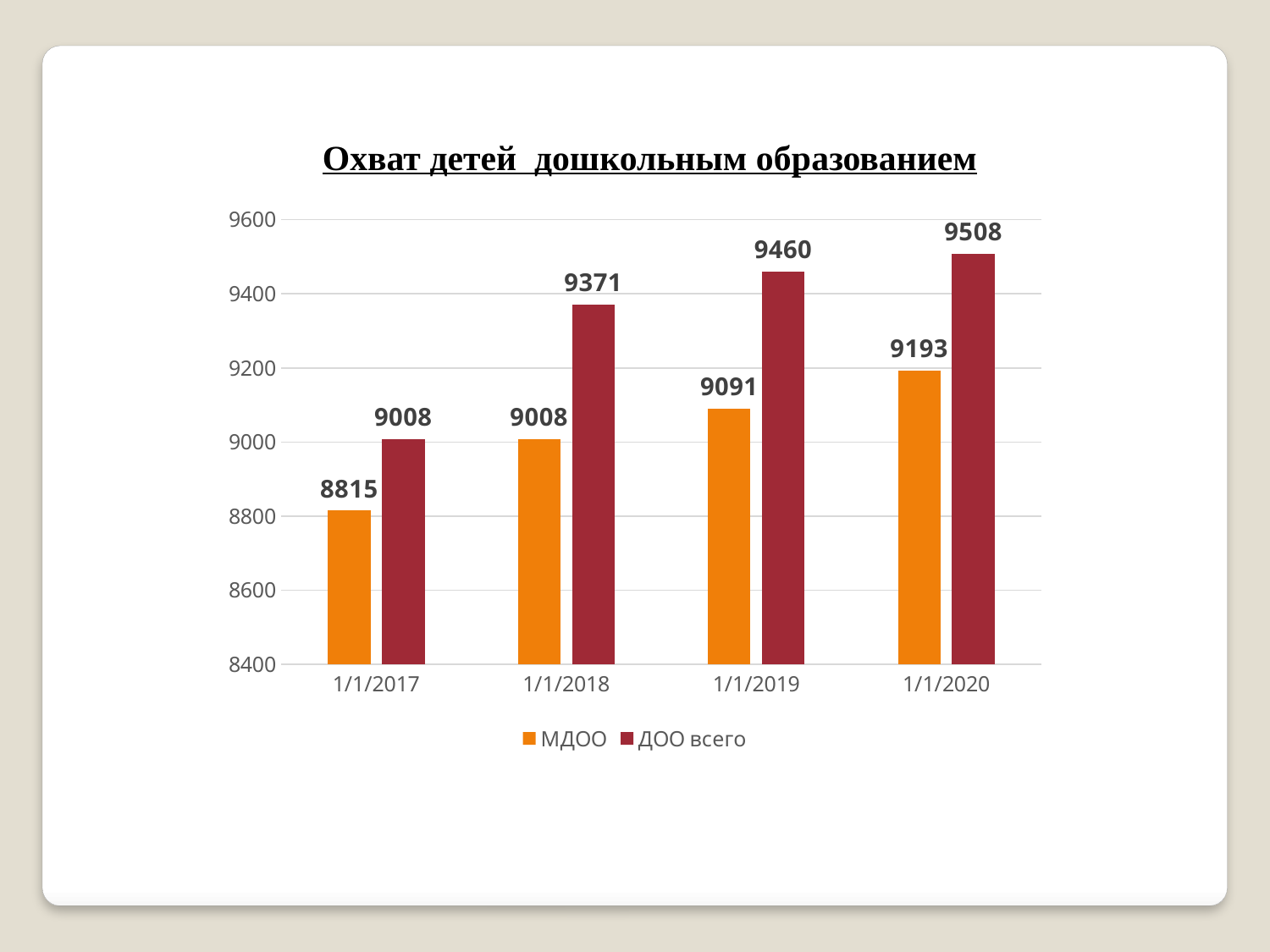
What is the value for ДОО всего on 1/1/2018? 9371 How many dates are shown on the x axis? 4 On which date is the value for ДОО всего highest? 1/1/2020 Do the values for ДОО всего rise or fall from 1/1/2017 to 1/1/2020? rise Which is larger on 1/1/2019: МДОО or ДОО всего? ДОО всего What is the value for ДОО всего on 1/1/2020? 9508 What is the difference between ДОО всего and МДОО on 1/1/2020? 315 How many series does the legend list? 2 By how much did the МДОО value increase from 1/1/2017 to 1/1/2020? 378 What is the value for МДОО on 1/1/2017? 8815 On which date is the value for МДОО lowest? 1/1/2017 What is the value for МДОО on 1/1/2019? 9091